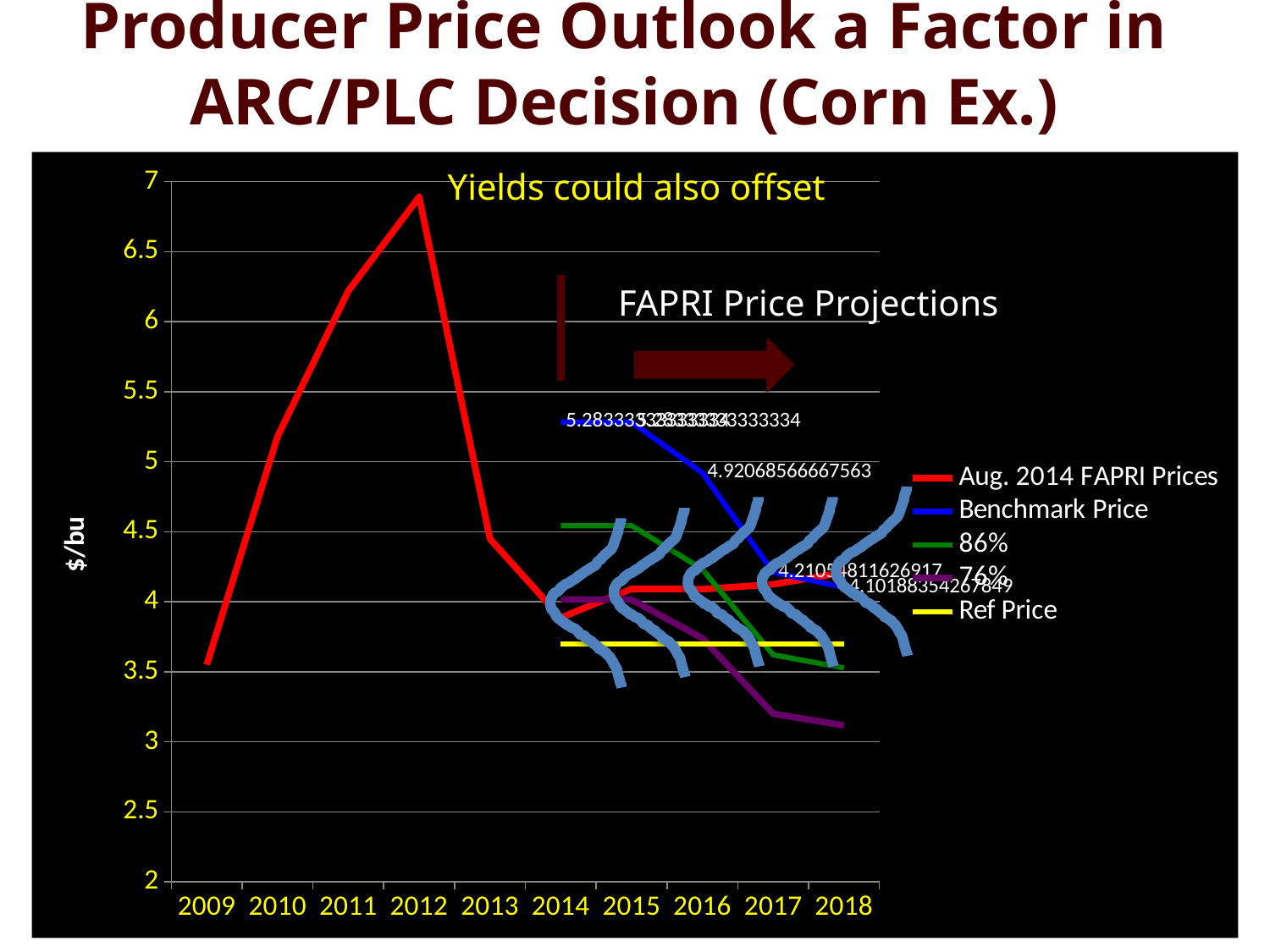
In which year does the Aug. 2014 FAPRI Prices line reach its highest value? 2012 In which year is the Aug. 2014 FAPRI Prices line at its lowest value? 2009 How many years are shown on the x axis? 10 In 2018, which is higher: the 86% line or the 76% line? 86% How many series does the legend list? 5 Is the Aug. 2014 FAPRI Prices value for 2012 greater or less than 6.5? greater What type of chart is shown on the slide? line chart Is the Benchmark Price value for 2014 greater or less than 5? greater Is the 76% line value for 2018 greater or less than 3.5? less Does the Aug. 2014 FAPRI Prices line rise or fall from 2009 to 2012? rise What is the label on the vertical axis? $/bu